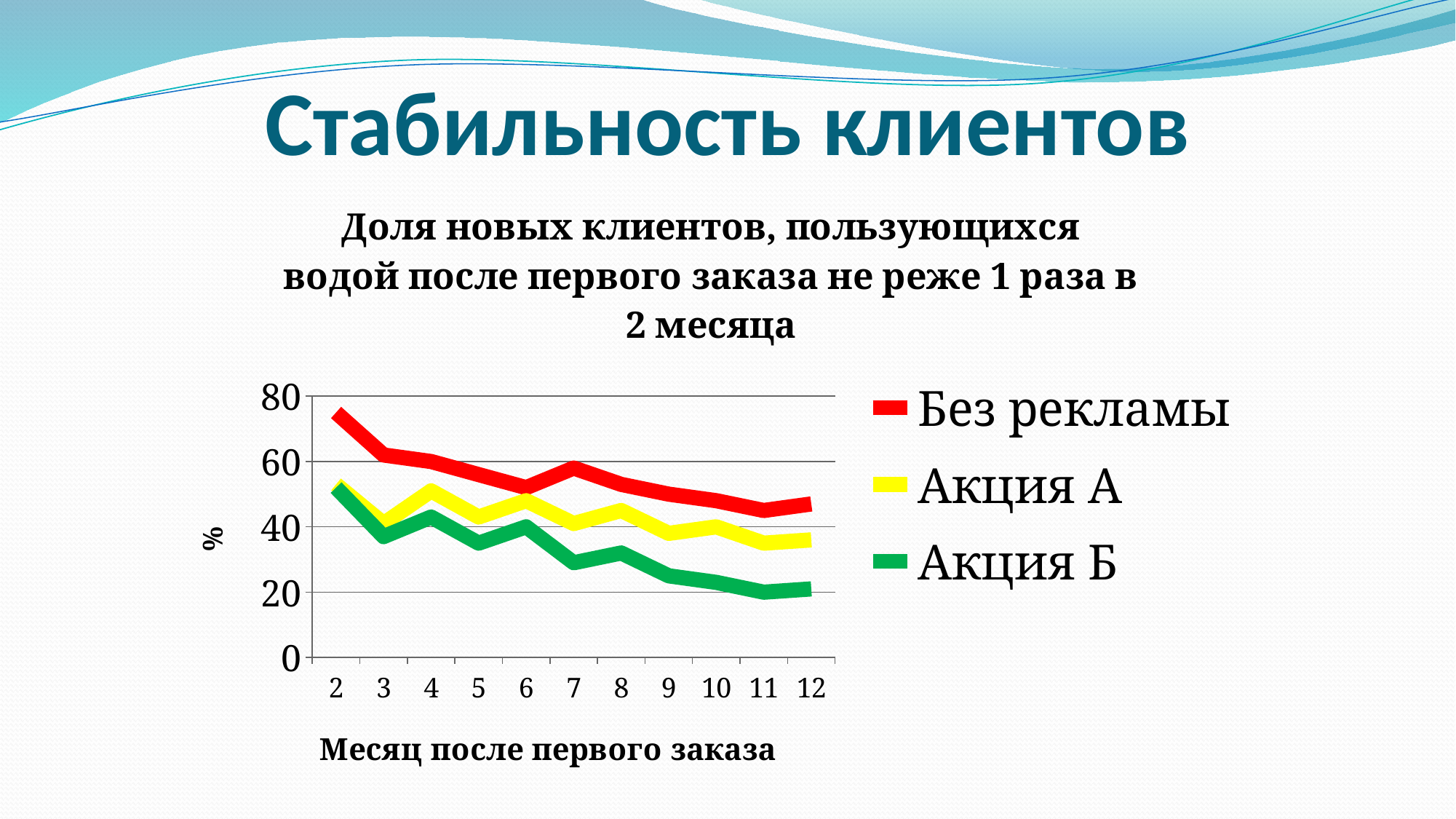
Which series has the highest value at month 2? Без рекламы Is the value for Без рекламы at month 12 greater or less than 60? less Is the value for Без рекламы at month 2 greater or less than 60? greater At month 7, which is larger: the value for Без рекламы or the value for Акция А? Без рекламы Is the value for Акция А at month 12 greater or less than 40? less What is the label of the x axis? Месяц после первого заказа Which series has the lowest value at month 12? Акция Б How many series does the legend list? 3 What kind of chart is shown on the slide? line chart How many months are plotted along the x axis? 11 Does the value for Без рекламы generally rise or fall from month 2 to month 12? fall